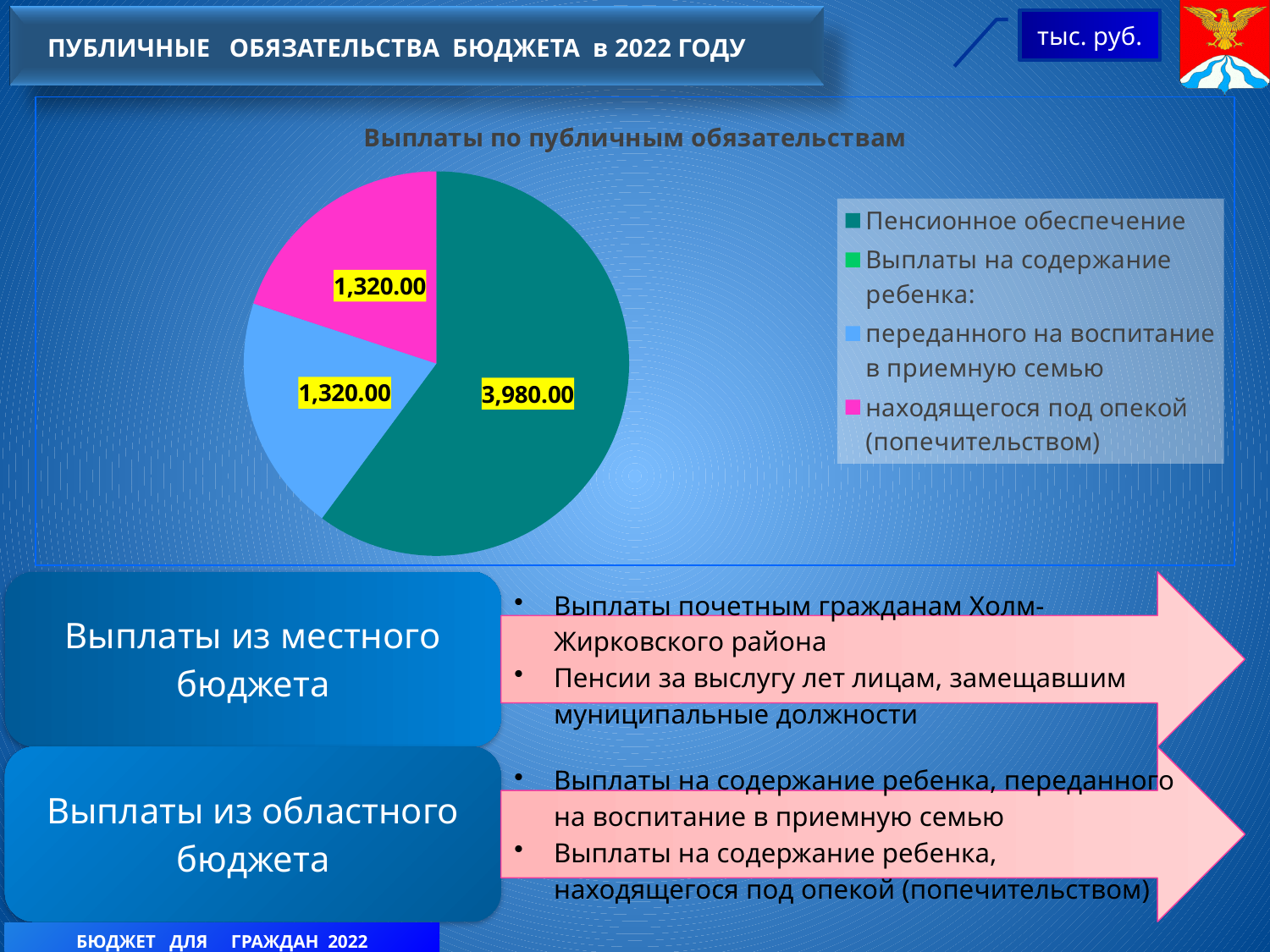
What is the value of the slice for Пенсионное обеспечение? 3,980.00 What is the total of all the labelled slices in the pie chart? 6,620.00 What is the title of the chart? Выплаты по публичным обязательствам What colour is the slice for Пенсионное обеспечение? teal (dark green) What is the value of the slice for переданного на воспитание в приемную семью? 1,320.00 What kind of chart is shown on the slide? pie chart Which category has the largest slice in the pie chart? Пенсионное обеспечение What is the difference between the value for Пенсионное обеспечение and the value for находящегося под опекой (попечительством)? 2,660.00 Which is larger: the value for Пенсионное обеспечение or the value for переданного на воспитание в приемную семью? Пенсионное обеспечение How many slices with data labels are shown in the pie chart? 3 How many entries does the chart legend list? 4 What is the value of the slice for находящегося под опекой (попечительством)? 1,320.00